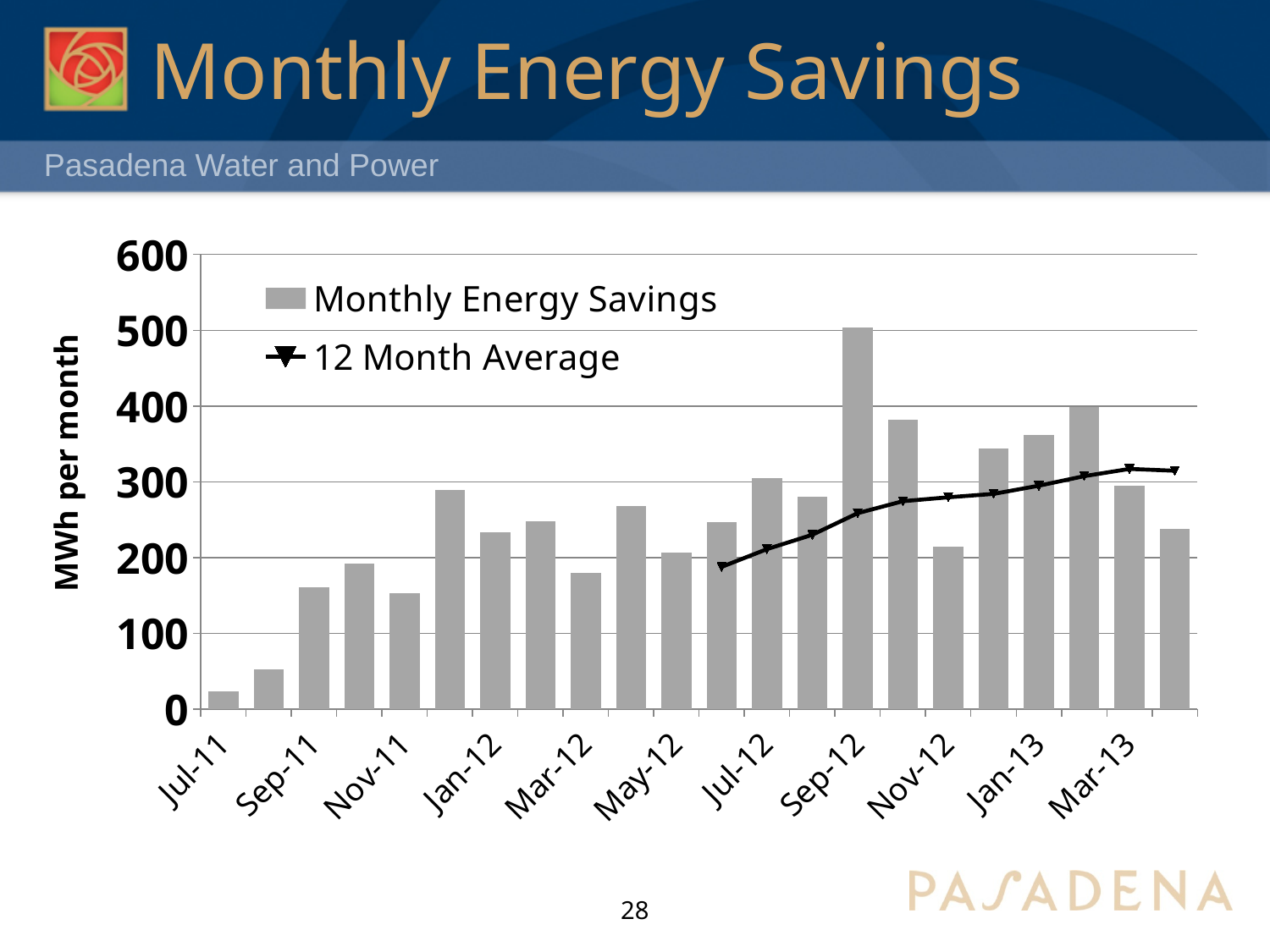
How many series does the legend list? 2 Does the 12 Month Average line generally rise or fall from Jul-12 to Mar-13? rise What is the label on the vertical axis? MWh per month What kind of chart is shown on the slide? bar chart with a line overlay What are the two entries listed in the legend? Monthly Energy Savings and 12 Month Average Is the Monthly Energy Savings value for Jul-11 greater or less than 100? less Which month has the highest Monthly Energy Savings bar? Sep-12 Is the Monthly Energy Savings value for Jan-12 greater or less than 200? greater Which month has the lowest Monthly Energy Savings bar? Jul-11 Is the Monthly Energy Savings value for Sep-12 greater or less than 400? greater Which has the larger Monthly Energy Savings value, Jan-12 or Mar-12? Jan-12